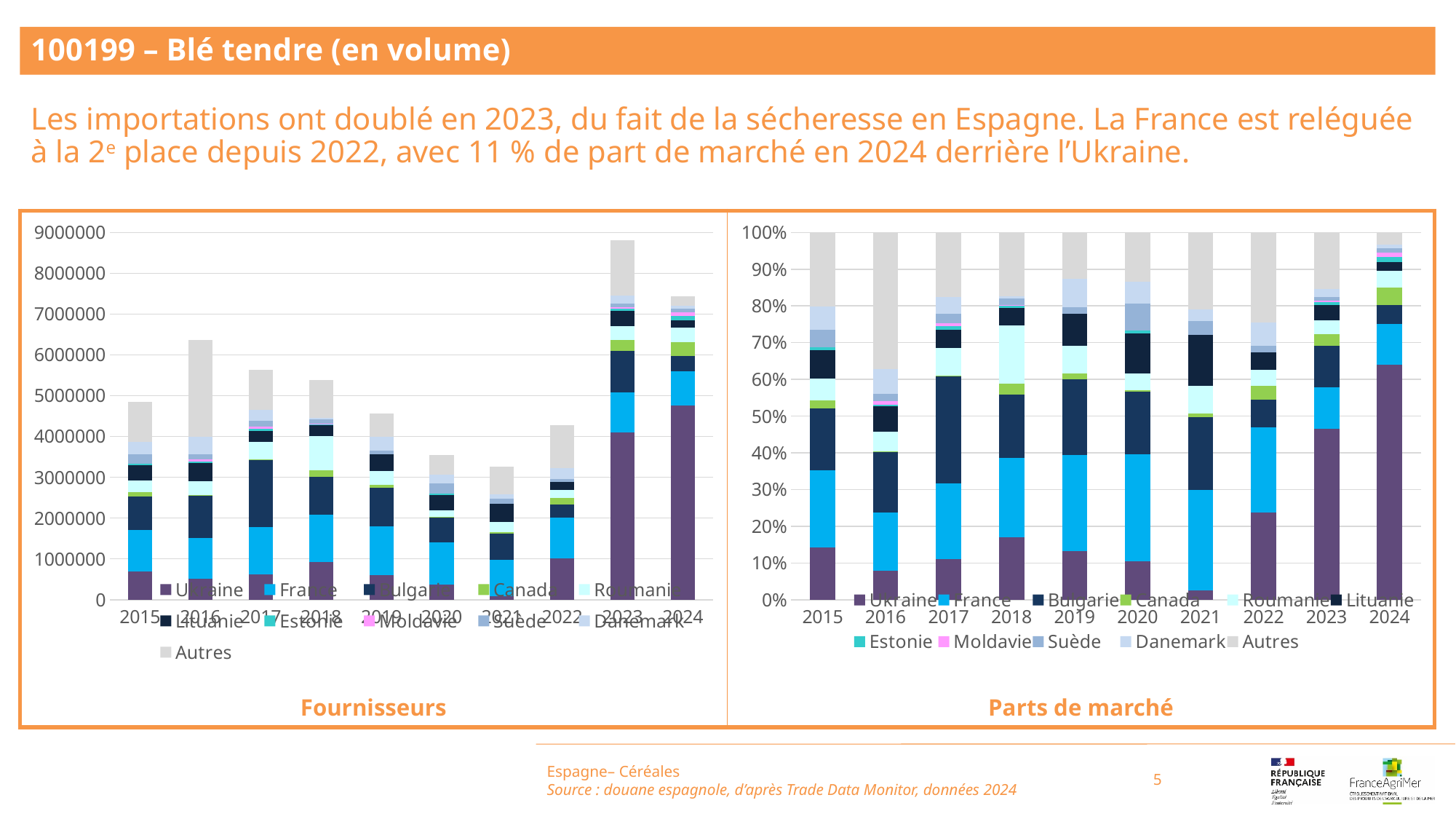
How many years are shown on the x axis of the Fournisseurs chart? 10 What kind of chart is the Fournisseurs chart on the left? Stacked bar chart In the Fournisseurs chart, which year has the highest total bar? 2023 In the Fournisseurs chart, is the total for 2023 greater or less than 8000000? greater In the Parts de marché chart, is the share of Ukraine in 2024 greater or less than 50%? greater How many series does the legend of the Parts de marché chart list? 11 In the Fournisseurs chart, which year has the larger total bar, 2015 or 2016? 2016 In the Parts de marché chart, does the share of Ukraine rise or fall from 2021 to 2024? rise Which series is listed first in the legend of the Fournisseurs chart? Ukraine In the Fournisseurs chart, which year has the lowest total bar? 2021 In the Fournisseurs chart, is the total for 2021 greater or less than 4000000? less What is the title of the chart on the right? Parts de marché